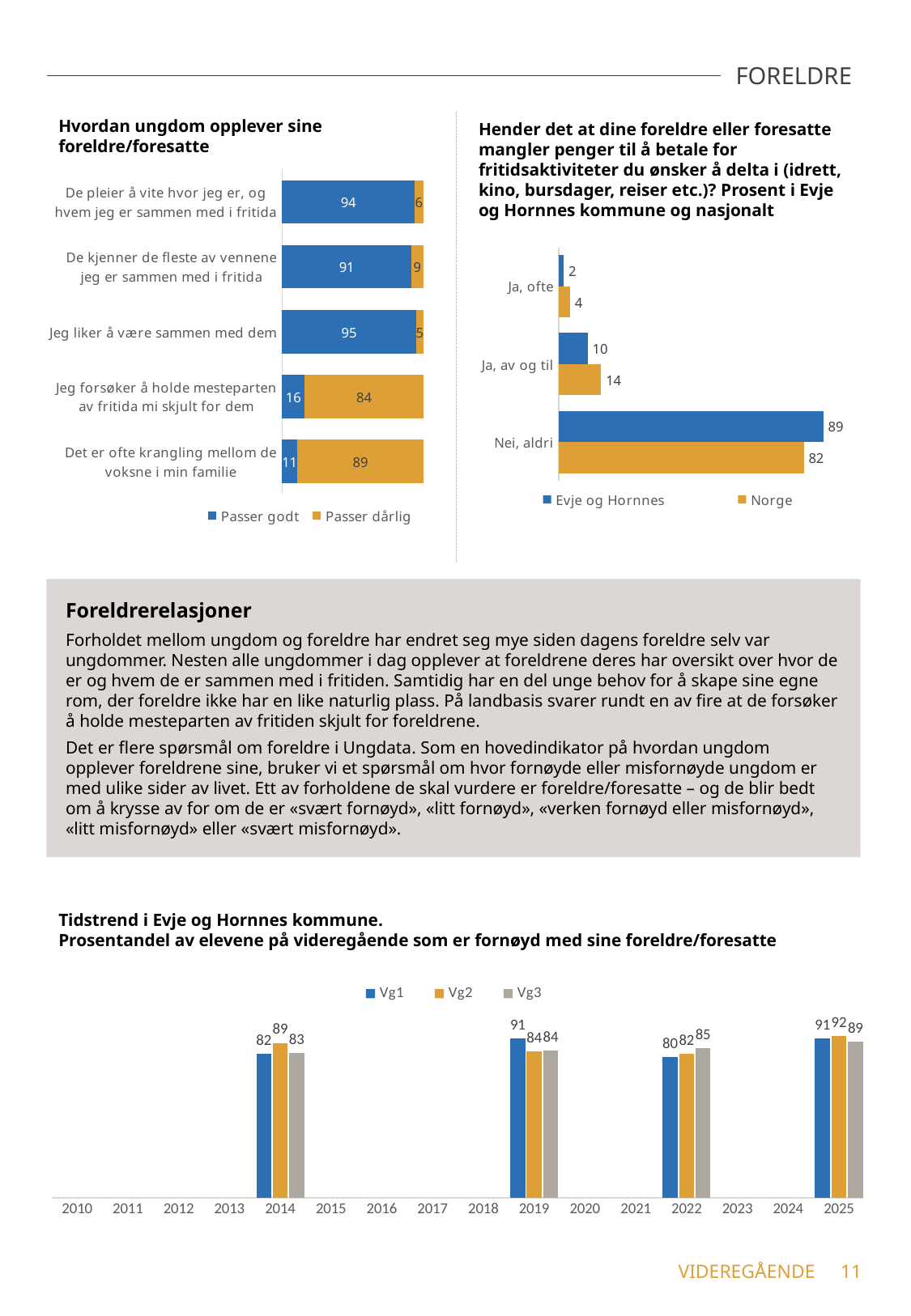
How many statements (categories) are shown in the chart 'Hvordan ungdom opplever sine foreldre/foresatte'? 5 In the chart 'Hvordan ungdom opplever sine foreldre/foresatte', what is the 'Passer godt' value for 'Jeg liker å være sammen med dem'? 95 What kind of chart is 'Tidstrend i Evje og Hornnes kommune'? Bar chart How many series does the legend list in the chart 'Hender det at dine foreldre eller foresatte mangler penger...'? 2 In the chart 'Hvordan ungdom opplever sine foreldre/foresatte', what is the 'Passer dårlig' value for 'Det er ofte krangling mellom de voksne i min familie'? 89 In the chart 'Hvordan ungdom opplever sine foreldre/foresatte', what is the total of the stacked bar for 'Jeg forsøker å holde mesteparten av fritida mi skjult for dem'? 100 In the chart 'Hender det at dine foreldre eller foresatte mangler penger...', which is larger for 'Ja, ofte': Evje og Hornnes or Norge? Norge In the chart 'Hender det at dine foreldre eller foresatte mangler penger...', what is the value for 'Ja, av og til' for Norge? 14 In the chart 'Hender det at dine foreldre eller foresatte mangler penger...', what is the difference between Evje og Hornnes and Norge for 'Nei, aldri'? 7 In the chart 'Tidstrend i Evje og Hornnes kommune', what is the Vg2 value for 2025? 92 In the chart 'Tidstrend i Evje og Hornnes kommune', which year has the lowest Vg1 value? 2022 In the chart 'Hvordan ungdom opplever sine foreldre/foresatte', which statement has the lowest 'Passer godt' value? Det er ofte krangling mellom de voksne i min familie